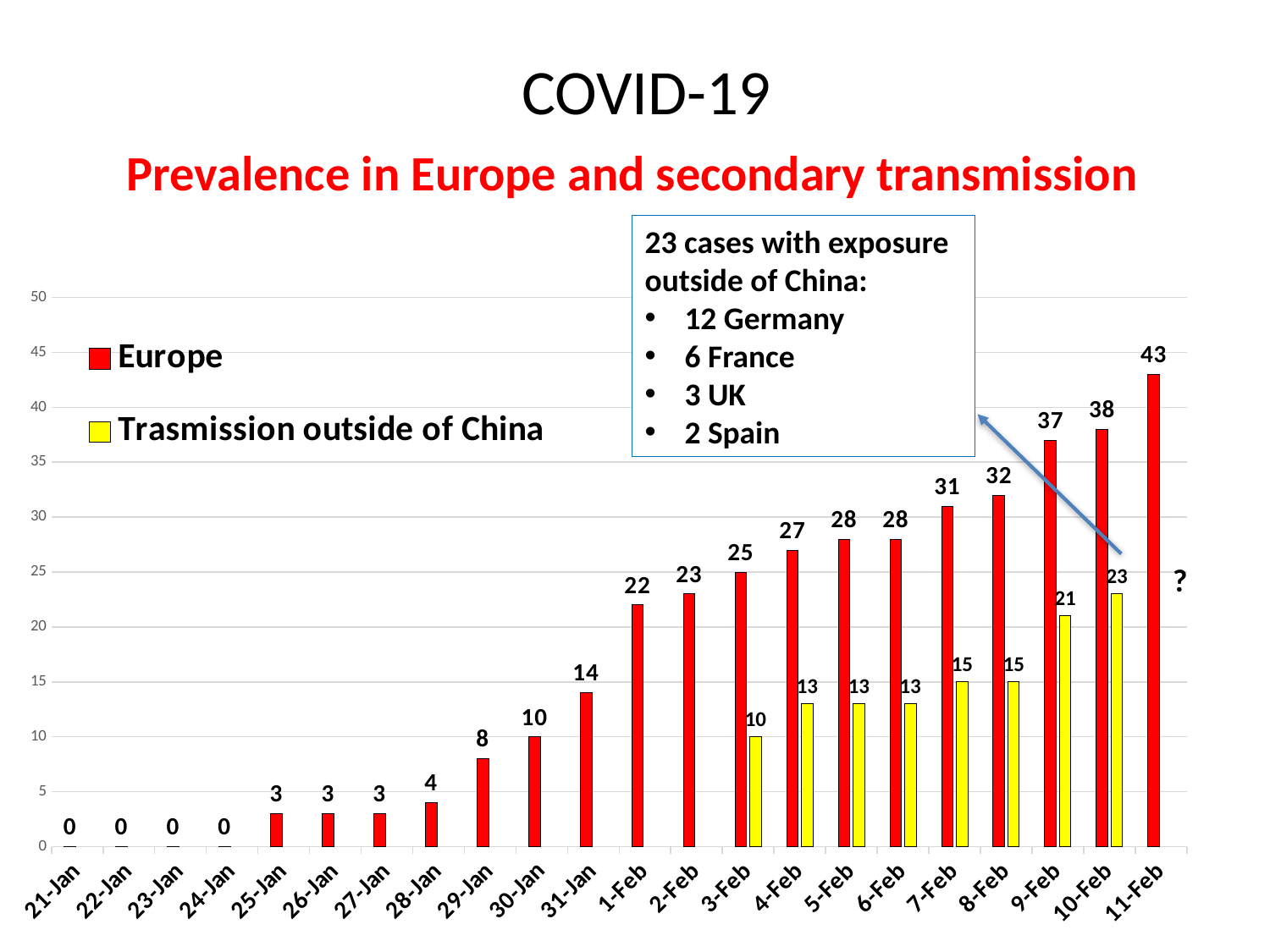
How many series does the legend list? 2 What kind of chart is shown on the slide? bar chart What is the difference between the Europe values on 31-Jan and 30-Jan? 4 How many dates are shown on the x axis? 22 What is the difference between the Europe value and the Trasmission outside of China value on 10-Feb? 15 What is the value for Europe on 29-Jan? 8 What is the value for Europe on 1-Feb? 22 Which is larger, the Europe value on 7-Feb or on 8-Feb? 8-Feb Do the Europe values rise or fall from 21-Jan to 11-Feb? rise On which date is the Europe value highest? 11-Feb What is the value for Trasmission outside of China on 3-Feb? 10 What is the value for Trasmission outside of China on 9-Feb? 21